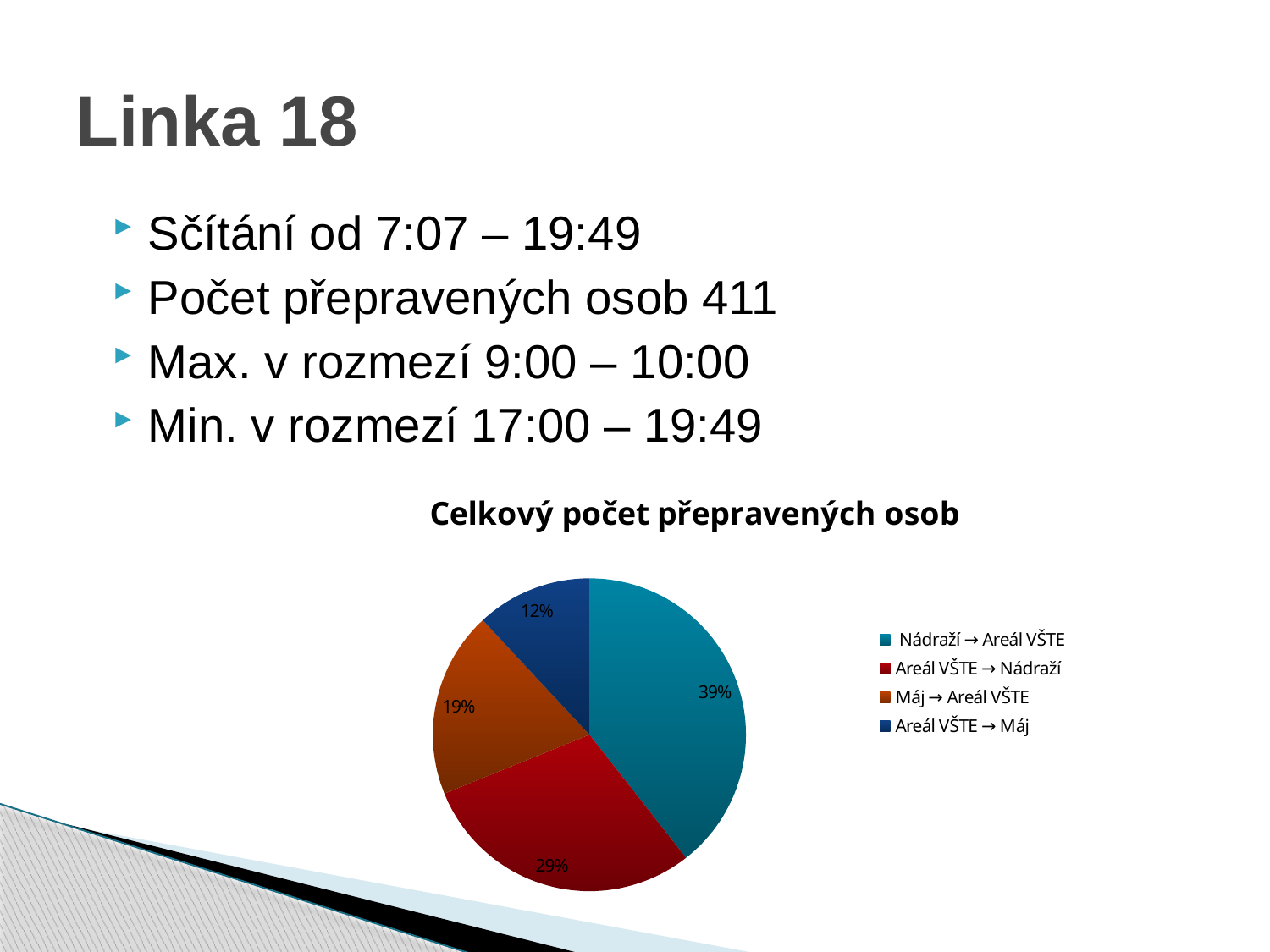
What type of chart is shown on the slide? pie chart What share of the pie does Nádraží → Areál VŠTE have? 39% What share of the pie does Máj → Areál VŠTE have? 19% How many categories does the pie chart show? 4 What is the difference in percentage points between Nádraží → Areál VŠTE and Areál VŠTE → Nádraží? 10 What is the chart's title? Celkový počet přepravených osob What share of the pie does Areál VŠTE → Nádraží have? 29% Which category has the smallest slice of the pie? Areál VŠTE → Máj Which is larger: Máj → Areál VŠTE or Areál VŠTE → Máj? Máj → Areál VŠTE Which category has the largest slice of the pie? Nádraží → Areál VŠTE What colour is the slice for Areál VŠTE → Nádraží? red